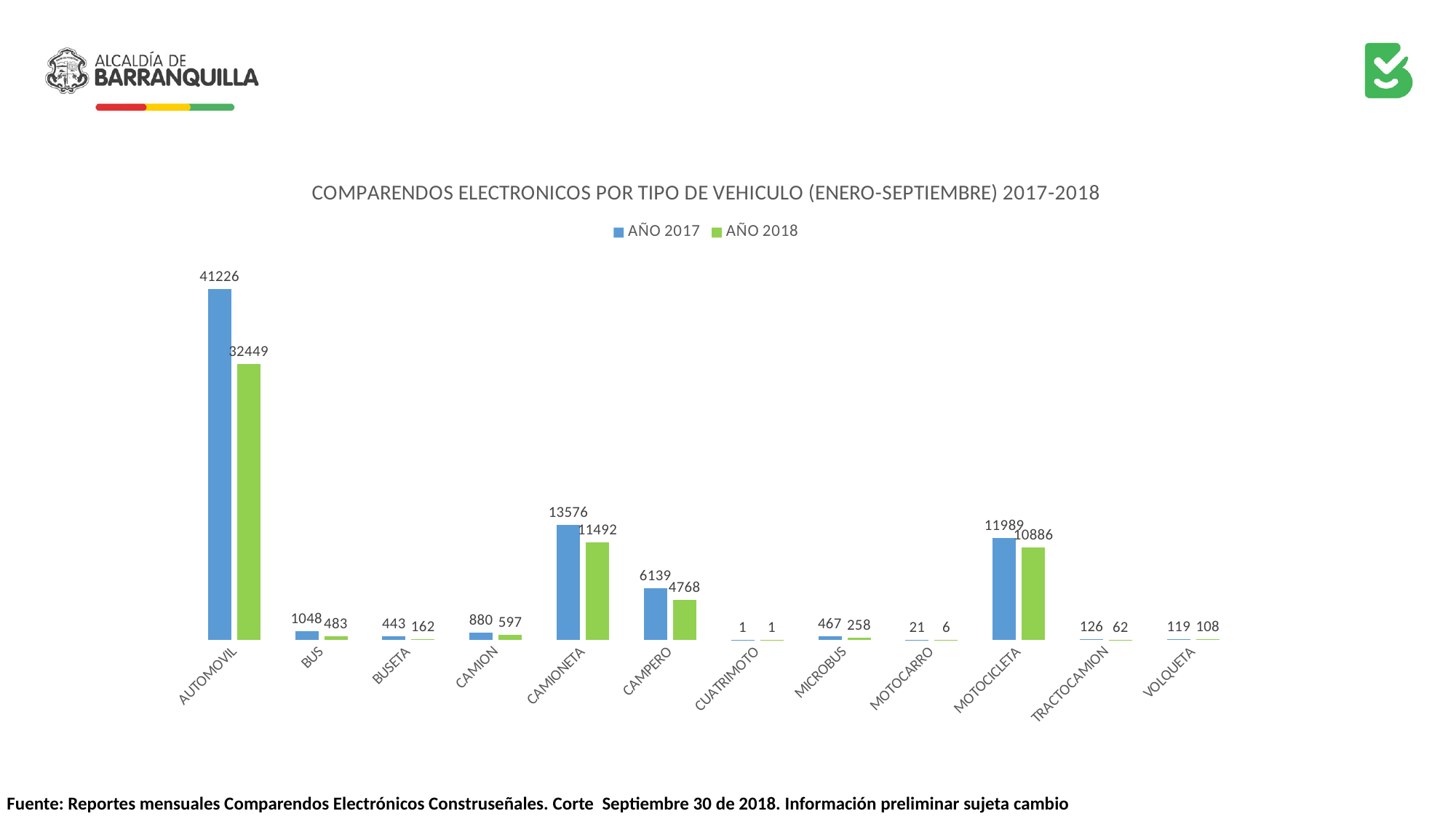
What is the value for CAMPERO in the AÑO 2017 series? 6139 What is the title of the chart? COMPARENDOS ELECTRONICOS POR TIPO DE VEHICULO (ENERO-SEPTIEMBRE) 2017-2018 What is the value for MOTOCICLETA in the AÑO 2018 series? 10886 Which vehicle type has the highest value in the AÑO 2018 series? AUTOMOVIL What is the difference between the AÑO 2017 and AÑO 2018 values for CAMIONETA? 2084 How many series does the legend list? 2 What is the value for AUTOMOVIL in the AÑO 2017 series? 41226 What is the difference between the AÑO 2017 and AÑO 2018 values for AUTOMOVIL? 8777 Which vehicle type has the lowest value in the AÑO 2017 series? CUATRIMOTO How many vehicle types are shown on the x axis? 12 What kind of chart is shown on the slide? Bar chart Which is larger for BUS: the AÑO 2017 value or the AÑO 2018 value? AÑO 2017